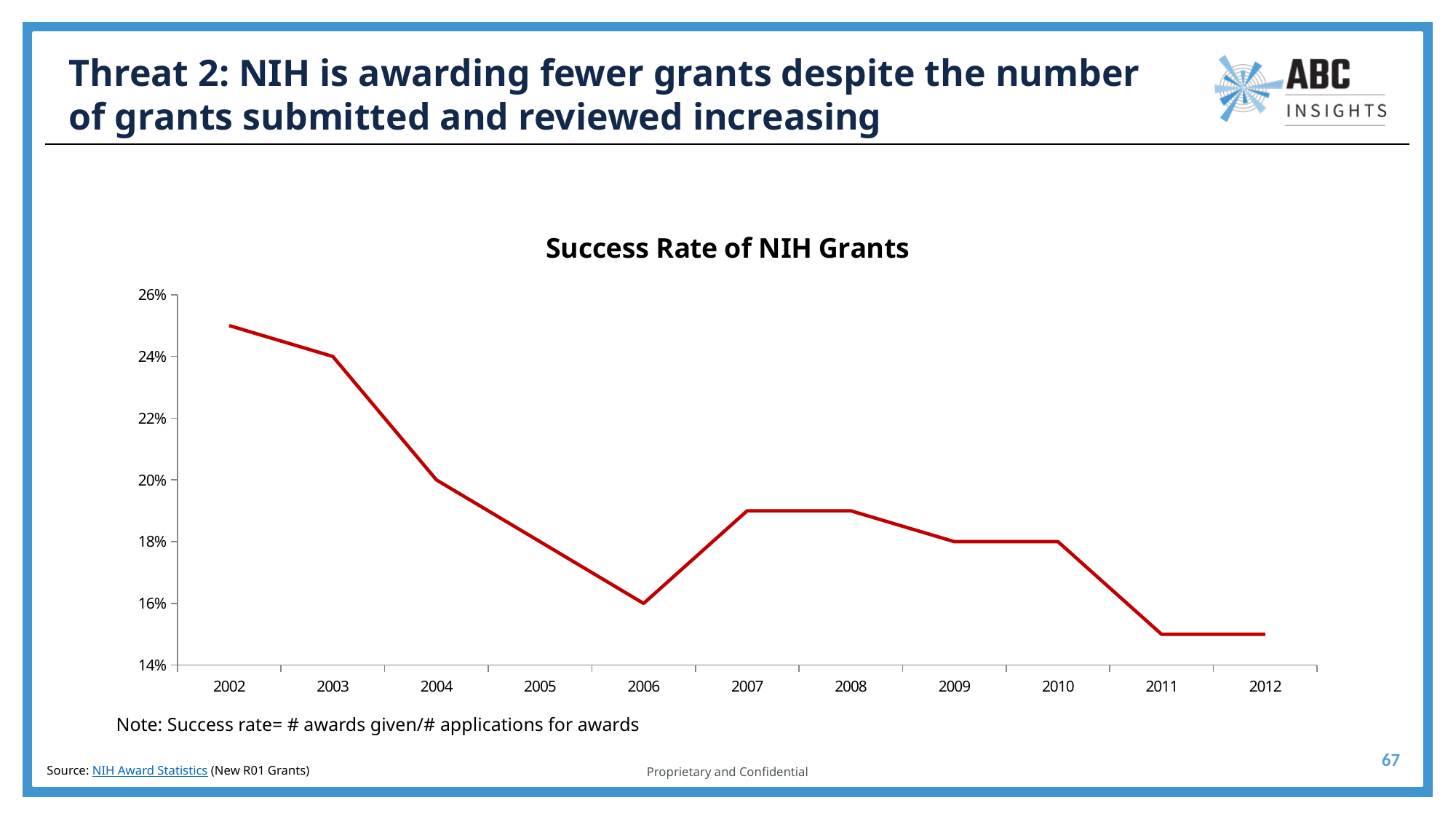
How many years are plotted on the x axis? 11 What type of chart is shown on the slide? Line chart Does the success rate generally rise or fall from 2002 to 2012? Fall What is the title of the chart? Success Rate of NIH Grants What was the success rate of NIH grants in 2009? 18% Which year has the highest success rate on the chart? 2002 What was the success rate of NIH grants in 2004? 20% By how many percentage points did the success rate fall from 2003 to 2004? 4 percentage points Which year had a higher success rate, 2003 or 2006? 2003 What was the success rate of NIH grants in 2003? 24% Is the success rate for 2011 greater or less than 16%? less What was the success rate of NIH grants in 2006? 16%